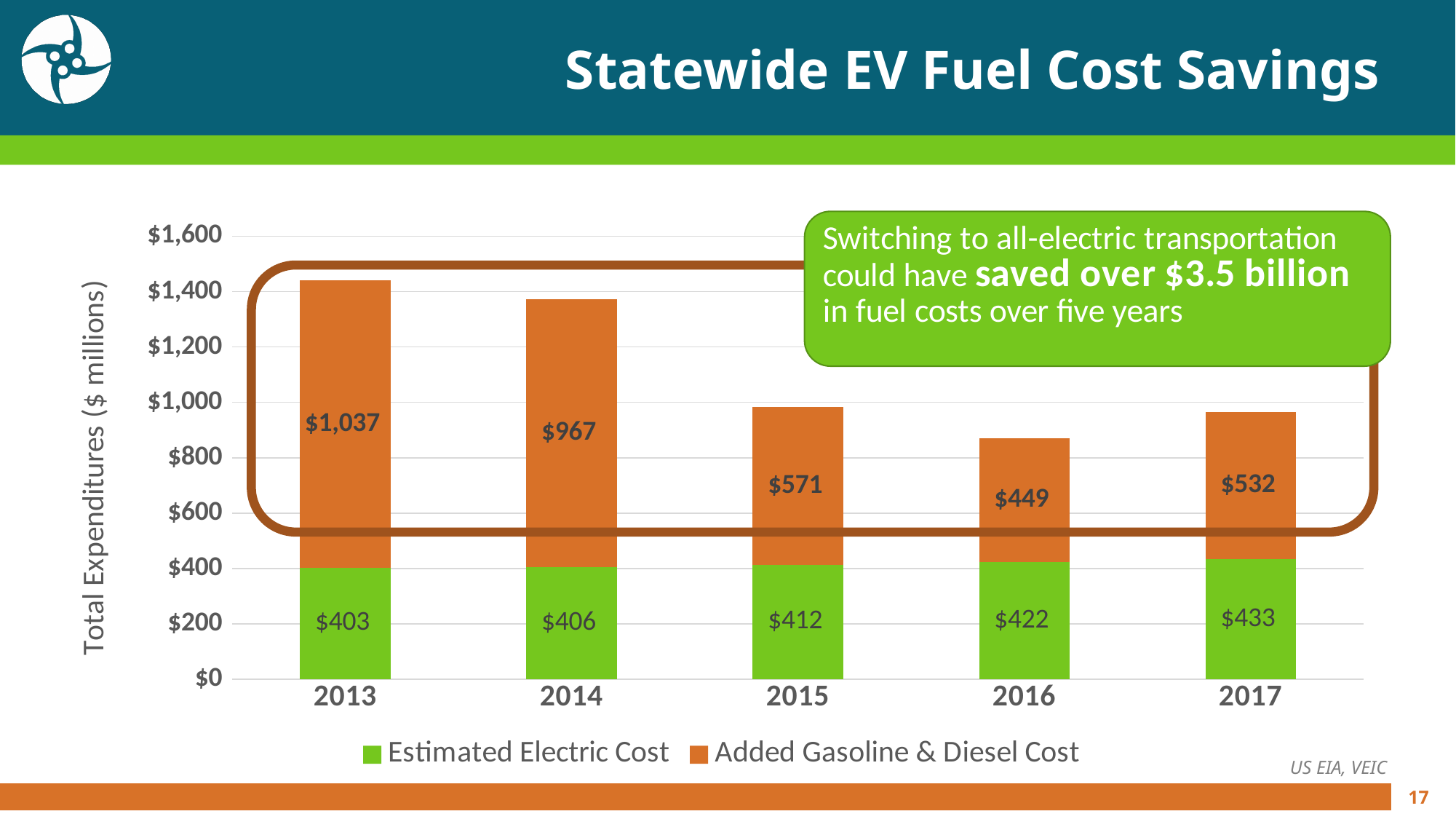
How many years are shown on the x axis? 5 How many series does the legend list? 2 Which is larger, the Added Gasoline & Diesel Cost in 2016 or in 2017? 2017 What is the total of the stacked bar for 2016? $871 What is the Added Gasoline & Diesel Cost for 2016? $449 Which year has the highest Added Gasoline & Diesel Cost? 2013 What is the total of the stacked bar for 2013? $1,440 What is the difference between the Added Gasoline & Diesel Cost in 2014 and in 2015? $396 What is the Added Gasoline & Diesel Cost for 2013? $1,037 Which year has the lowest Estimated Electric Cost? 2013 What is the Estimated Electric Cost for 2017? $433 What type of chart is shown on the slide? Stacked bar chart